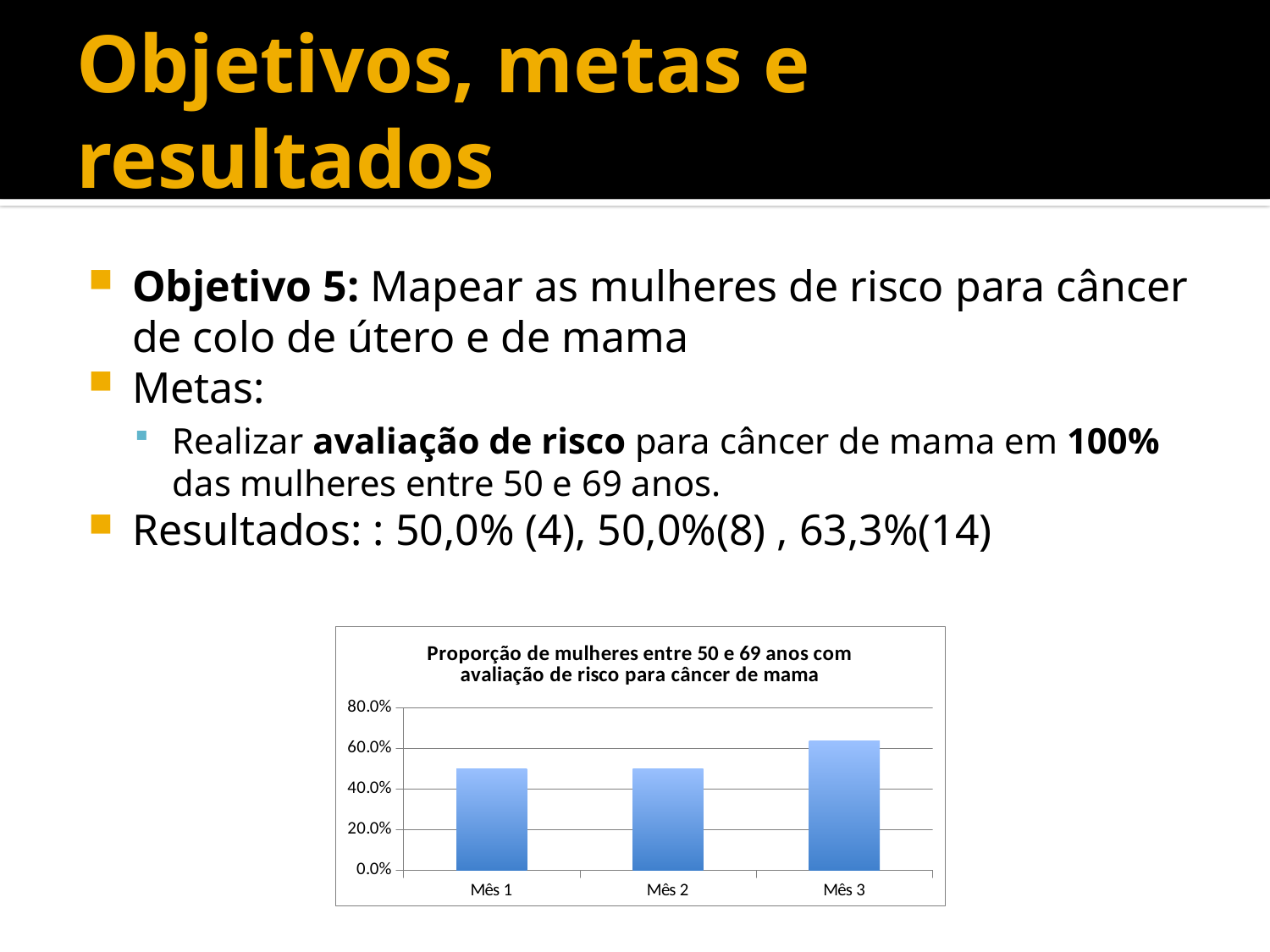
What is the title of the chart? Proporção de mulheres entre 50 e 69 anos com avaliação de risco para câncer de mama What kind of chart is shown on the slide? bar chart Do the values rise or fall from Mês 2 to Mês 3? rise Is the value for Mês 2 greater or less than 20.0%? greater Is the value for Mês 3 greater or less than 80.0%? less How many categories are shown on the x axis of the chart? 3 Which is larger, the value for Mês 3 or the value for Mês 2? Mês 3 Is the value for Mês 1 greater or less than 60.0%? less What is the highest value shown on the y axis of the chart? 80.0% Which month has the highest value in the chart? Mês 3